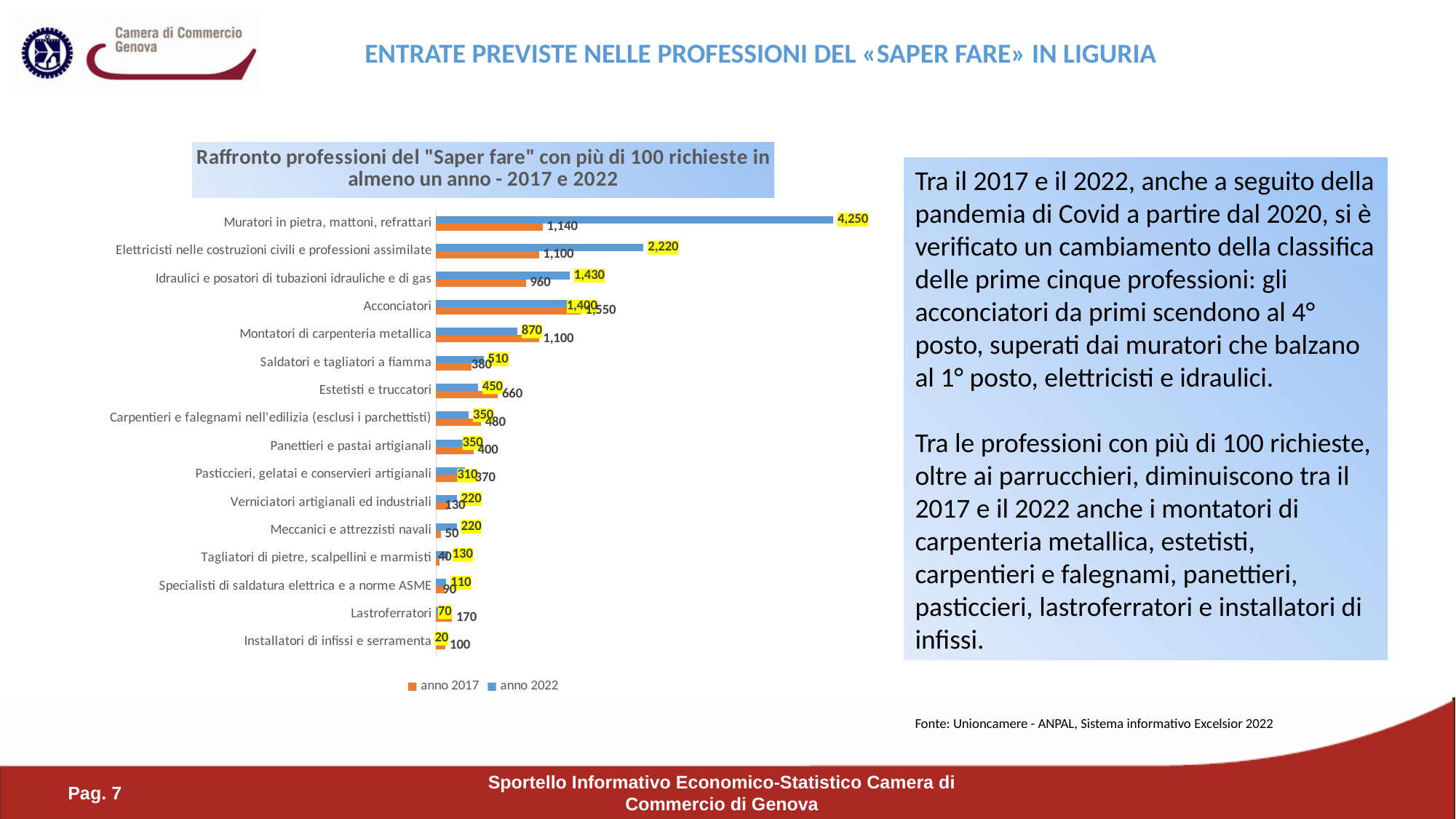
What is the value for anno 2017 for Meccanici e attrezzisti navali? 50 What is the value for anno 2022 for Idraulici e posatori di tubazioni idrauliche e di gas? 1,430 Which profession has the highest value for anno 2022? Muratori in pietra, mattoni, refrattari How many professions are shown in the chart? 16 What is the value for anno 2017 for Acconciatori? 1,550 What is the difference between the anno 2022 and anno 2017 values for Elettricisti nelle costruzioni civili e professioni assimilate? 1,120 How many series does the legend list? 2 What kind of chart is shown on the slide? Bar chart For Lastroferratori, which is larger: the anno 2017 value or the anno 2022 value? anno 2017 Which profession has the lowest value for anno 2022? Installatori di infissi e serramenta Which colour represents anno 2017 in the chart? Orange What is the value for anno 2022 for Muratori in pietra, mattoni, refrattari? 4,250